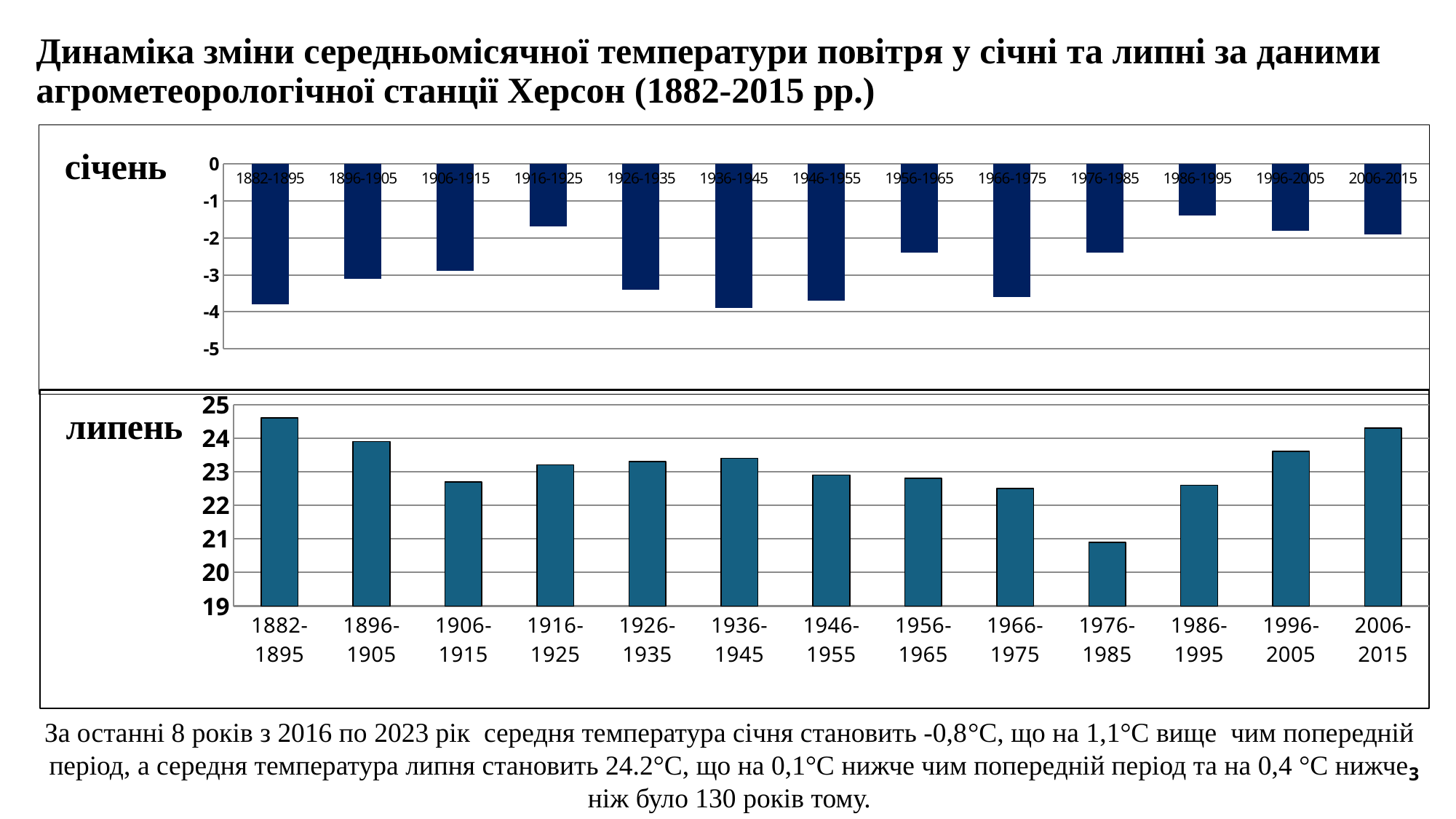
In the bottom chart (липень), which period has the lowest value? 1976-1985 In the top chart (січень), which is larger: the value for 1986-1995 or for 1966-1975? 1986-1995 In the bottom chart (липень), which period has the highest value? 1882-1895 How many periods (bars) are shown in the bottom chart labelled "липень"? 13 In the bottom chart (липень), is the value for 1882-1895 greater or less than 24? greater What is the range of the vertical axis in the bottom chart (липень)? 19 to 25 In the bottom chart (липень), which is larger: the value for 1896-1905 or for 1906-1915? 1896-1905 In the top chart (січень), is the value for 1916-1925 greater or less than -2? greater In the top chart (січень), which period has the highest (least negative) value? 1986-1995 What kind of chart is the top chart labelled "січень"? bar chart In the bottom chart (липень), is the value for 1976-1985 greater or less than 21? less